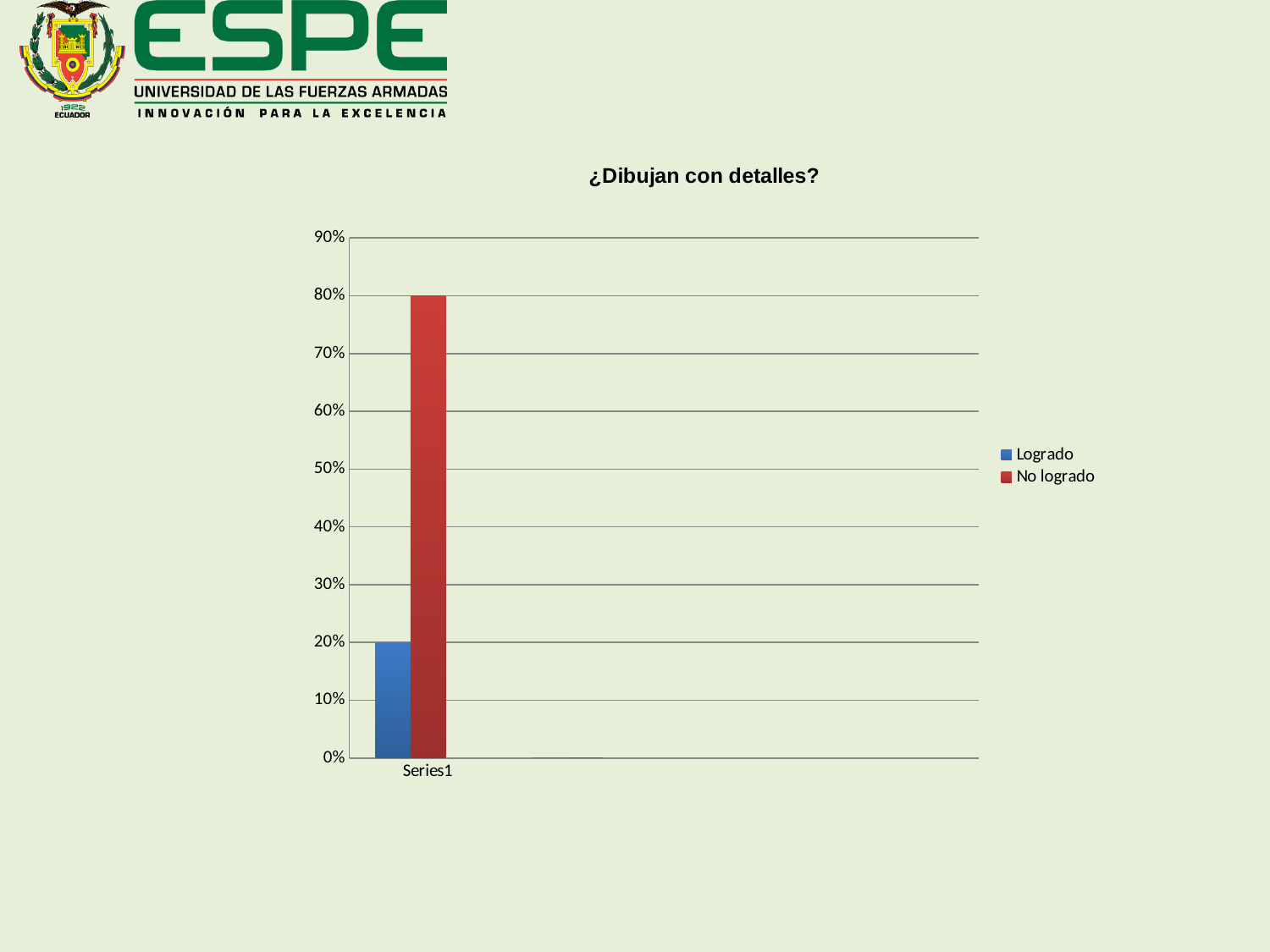
What is the value for No logrado? 80% What kind of chart is shown on the slide? bar chart How many categories are shown on the x axis? 1 Which series has the lowest value? Logrado How many series does the legend list? 2 Which series has the higher value, Logrado or No logrado? No logrado What is the title of the chart? ¿Dibujan con detalles? Is the value for No logrado greater or less than 50%? greater What is the difference between the No logrado value and the Logrado value? 60% Which series has the highest value? No logrado What are the two series listed in the legend? Logrado and No logrado What is the value for Logrado? 20%